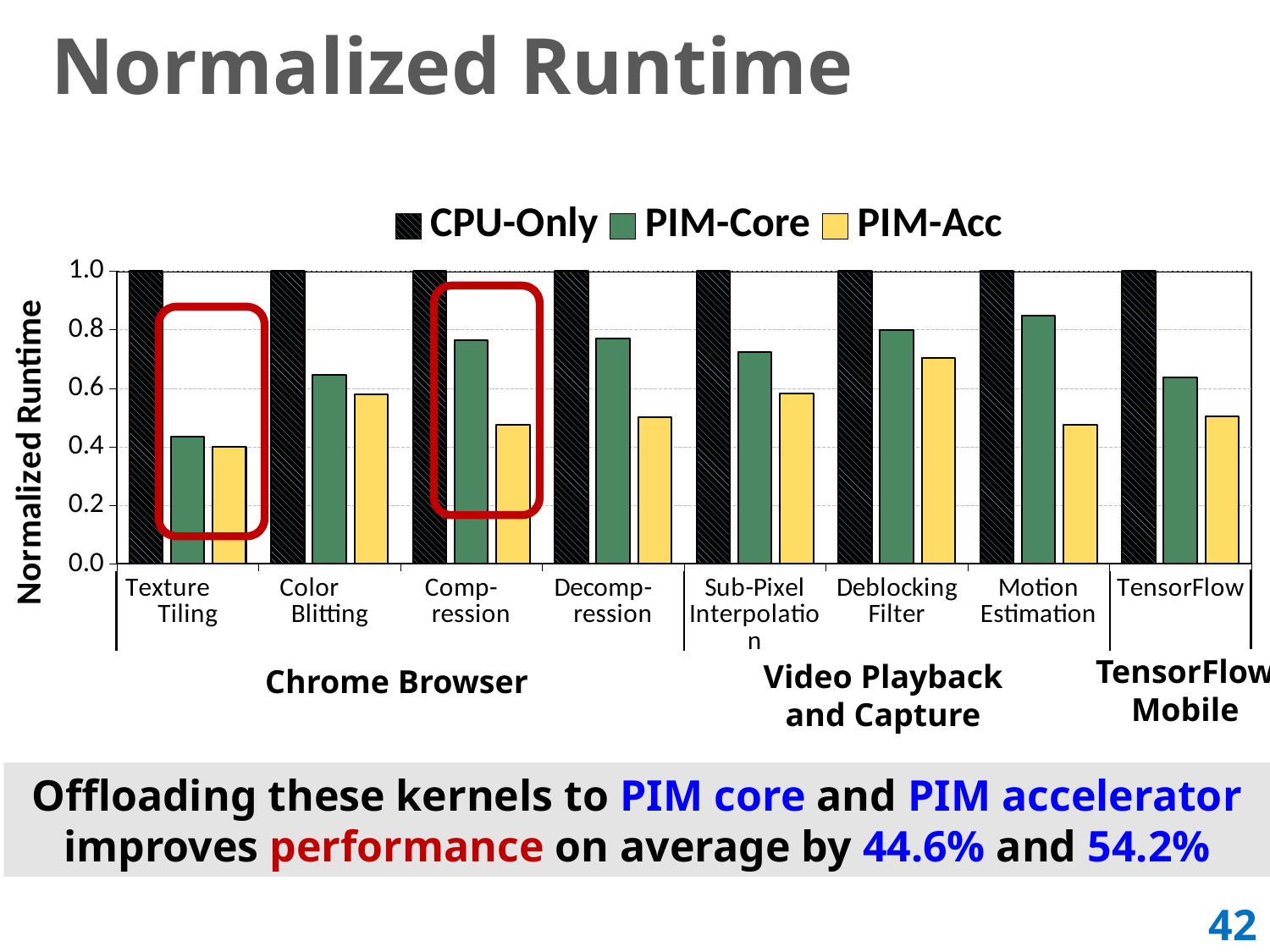
What is the label on the y axis of the chart? Normalized Runtime For Motion Estimation, which is larger: the PIM-Core value or the PIM-Acc value? PIM-Core What kind of chart is shown on the slide? bar chart Which kernel has the highest PIM-Acc normalized runtime? Deblocking Filter What is the CPU-Only normalized runtime for Texture Tiling? 1.0 How many kernels (categories) are plotted along the x axis? 8 Which kernel has the lowest PIM-Acc normalized runtime? Texture Tiling Is the PIM-Acc value for Texture Tiling greater or less than 0.6? less Which kernel has the highest PIM-Core normalized runtime? Motion Estimation How many series does the legend list? 3 Is the PIM-Core value for Compression greater or less than 0.6? greater Which kernel has the lowest PIM-Core normalized runtime? Texture Tiling